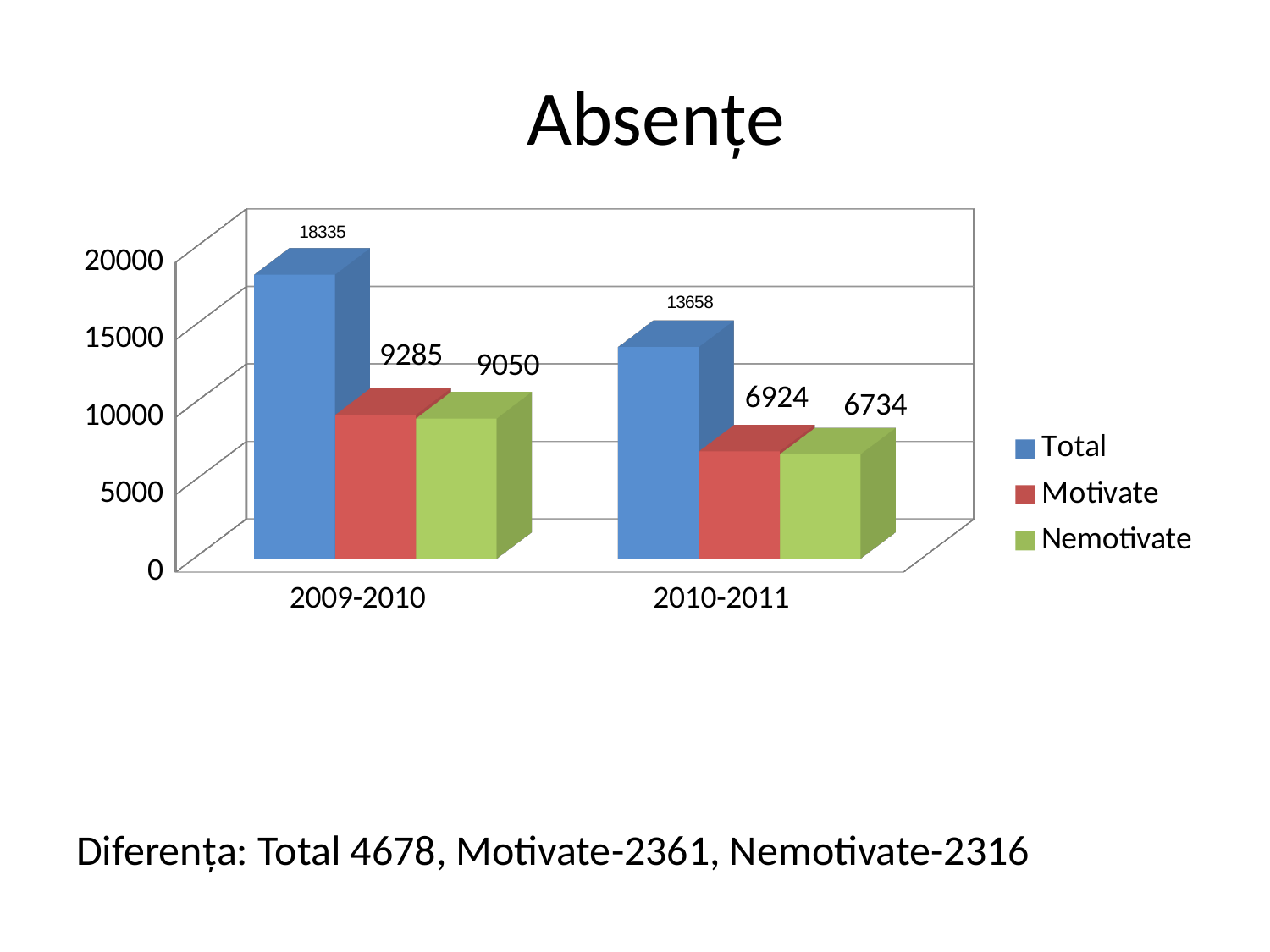
What is the Nemotivate value for 2009-2010? 9050 What is the difference between the Total values for 2009-2010 and 2010-2011? 4677 What kind of chart is shown on the slide? Bar chart What is the Total value for 2009-2010? 18335 How many series does the legend list? 3 What is the difference between Motivate and Nemotivate in 2009-2010? 235 Which series has the lowest value in 2010-2011? Nemotivate How many categories are shown on the x axis? 2 Is the Total value for 2010-2011 greater or less than 15000? less Is the Motivate value for 2009-2010 larger than the Motivate value for 2010-2011? Yes What is the Motivate value for 2010-2011? 6924 Which year has the higher Total value? 2009-2010